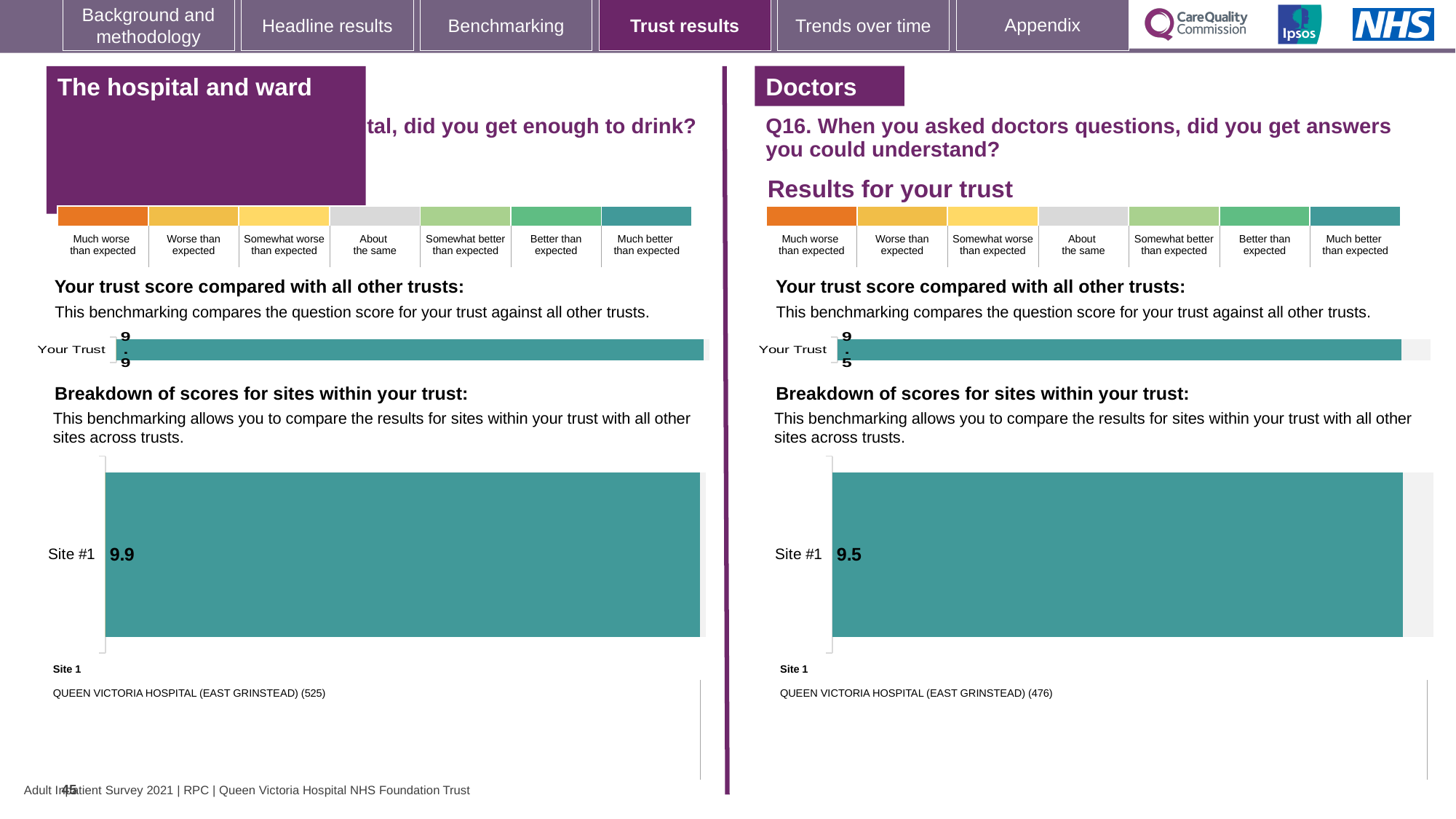
In the left-hand 'Breakdown of scores for sites within your trust' chart, what is the value for Site #1? 9.9 How many sites are plotted in the right-hand 'Breakdown of scores for sites within your trust' chart? 1 What kind of chart is the right-hand 'Breakdown of scores for sites within your trust' chart? bar chart What is the category label on the left-hand 'Your trust score compared with all other trusts' chart? Your Trust How many sites are plotted in the left-hand 'Breakdown of scores for sites within your trust' chart? 1 What is the difference between the Site #1 value in the left-hand breakdown chart and the Site #1 value in the right-hand breakdown chart? 0.4 In the right-hand (Doctors, Q16) 'Breakdown of scores for sites within your trust' chart, what is the value for Site #1? 9.5 In the left-hand 'Your trust score compared with all other trusts' chart, what is the value shown for Your Trust? 9.9 Is the Site #1 value in the left-hand breakdown chart larger or smaller than the Site #1 value in the right-hand breakdown chart? larger What is the category label on the right-hand 'Breakdown of scores for sites within your trust' chart? Site #1 In the right-hand (Doctors, Q16) 'Your trust score compared with all other trusts' chart, what is the value shown for Your Trust? 9.5